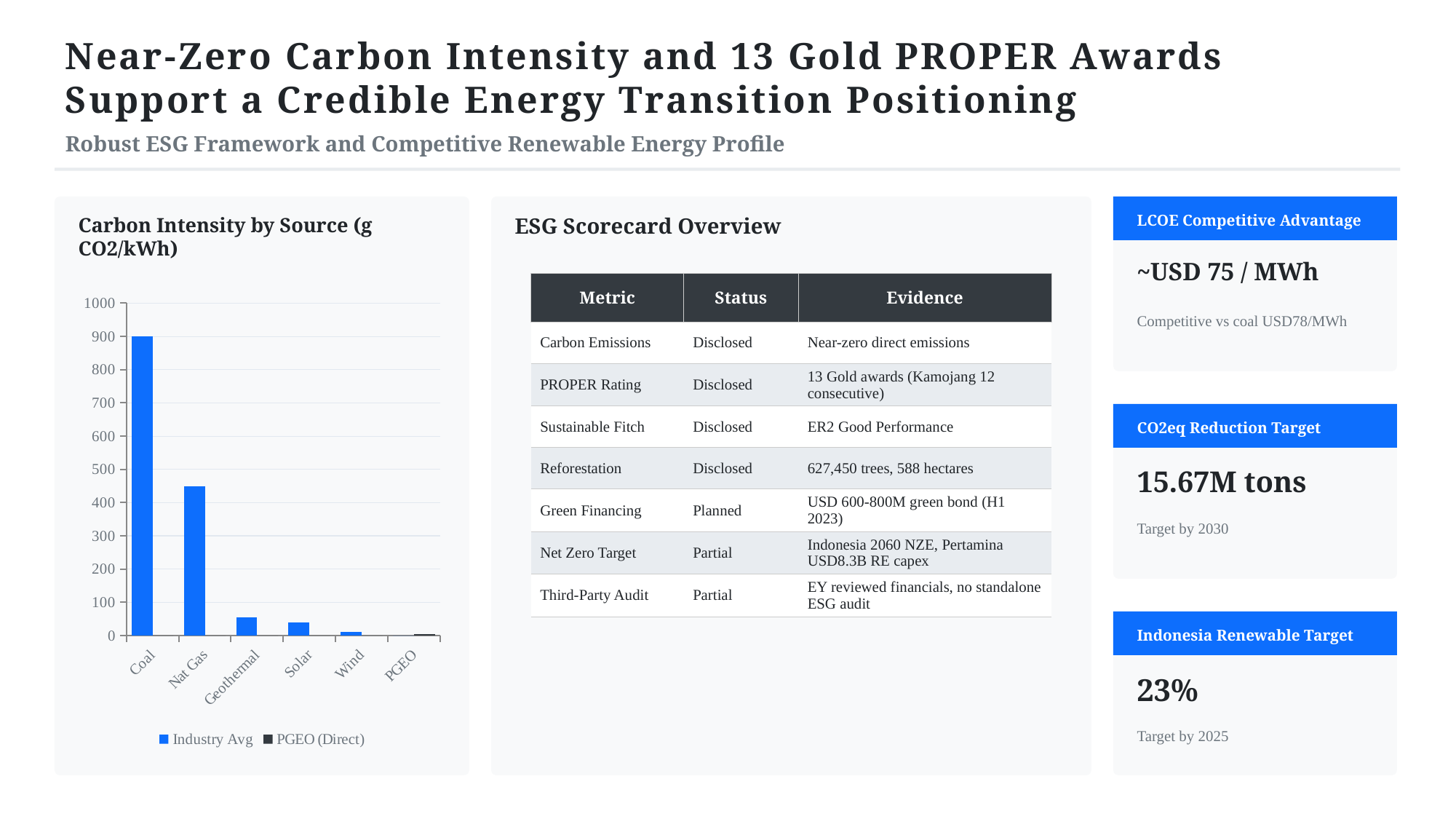
How many series does the legend of the Carbon Intensity by Source chart list? 2 What are the two legend entries in the Carbon Intensity by Source chart? Industry Avg and PGEO (Direct) In the Carbon Intensity by Source chart, is the value for Nat Gas greater or less than 400? greater In the Carbon Intensity by Source chart, which is larger, the value for Coal or the value for Nat Gas? Coal In the Carbon Intensity by Source chart, is the value for Nat Gas greater or less than 500? less In the Carbon Intensity by Source chart, which is larger, the value for Geothermal or the value for Wind? Geothermal In the Carbon Intensity by Source chart, what is the Industry Avg value for Coal? 900 Which source has the highest carbon intensity in the Carbon Intensity by Source chart? Coal In the Carbon Intensity by Source chart, is the value for Geothermal greater or less than 100? less What kind of chart is 'Carbon Intensity by Source (g CO2/kWh)'? bar chart How many source categories are shown on the x axis of the Carbon Intensity by Source chart? 6 Do the values in the Carbon Intensity by Source chart rise or fall moving from Coal to PGEO along the x axis? fall